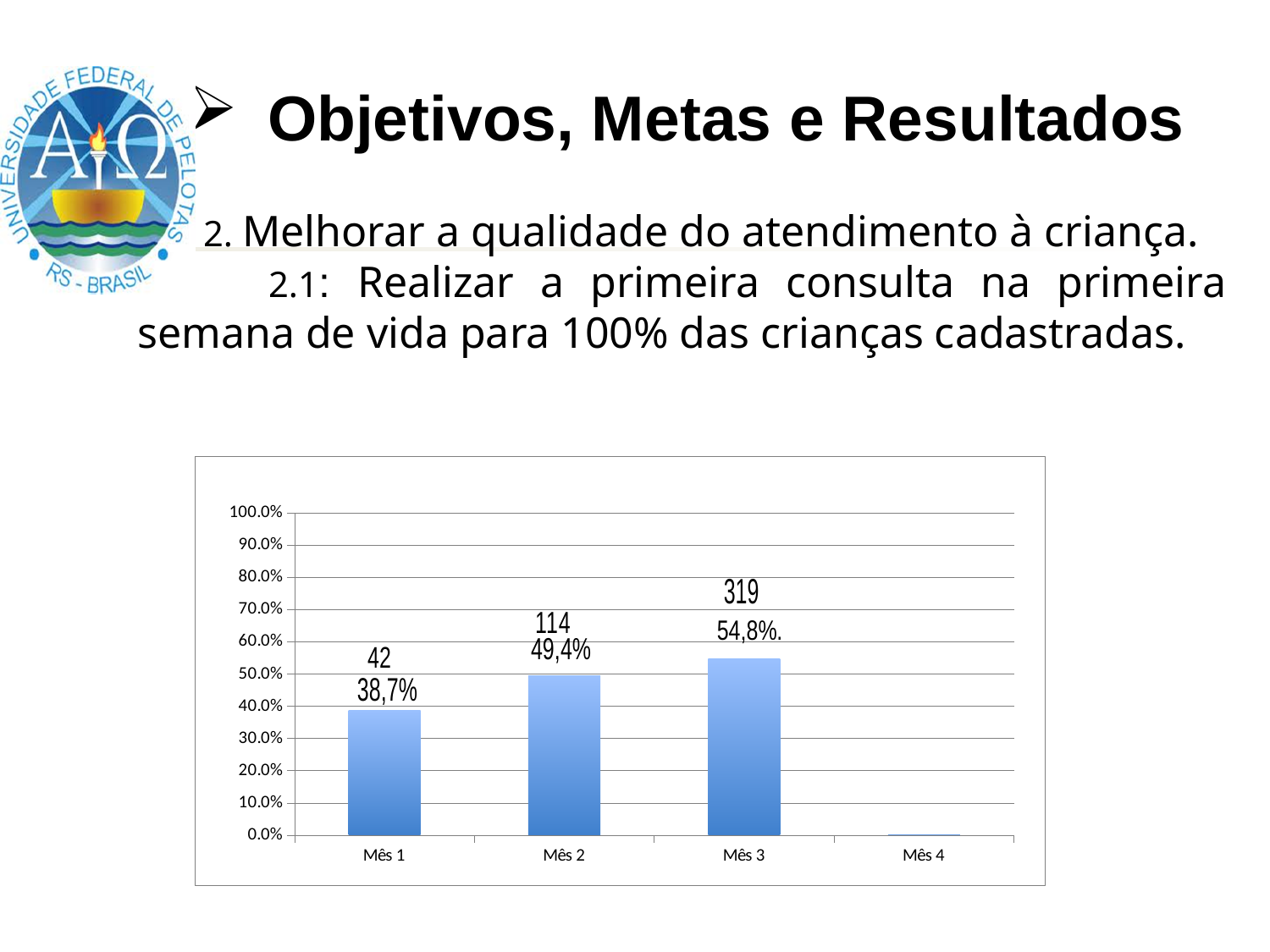
What is the difference between the percentages for Mês 3 and Mês 1? 16,1% What number is printed above the bar for Mês 3? 319 Which month has the highest bar? Mês 3 Which is larger, the percentage for Mês 2 or for Mês 1? Mês 2 What kind of chart is shown on the slide? bar chart How many months are shown on the x axis? 4 Which month has the lowest bar? Mês 4 What number is printed above the bar for Mês 1? 42 What percentage is shown for Mês 3? 54,8% Is the value for Mês 3 greater or less than 50%? greater What percentage is shown for Mês 2? 49,4% What percentage is shown for Mês 1? 38,7%